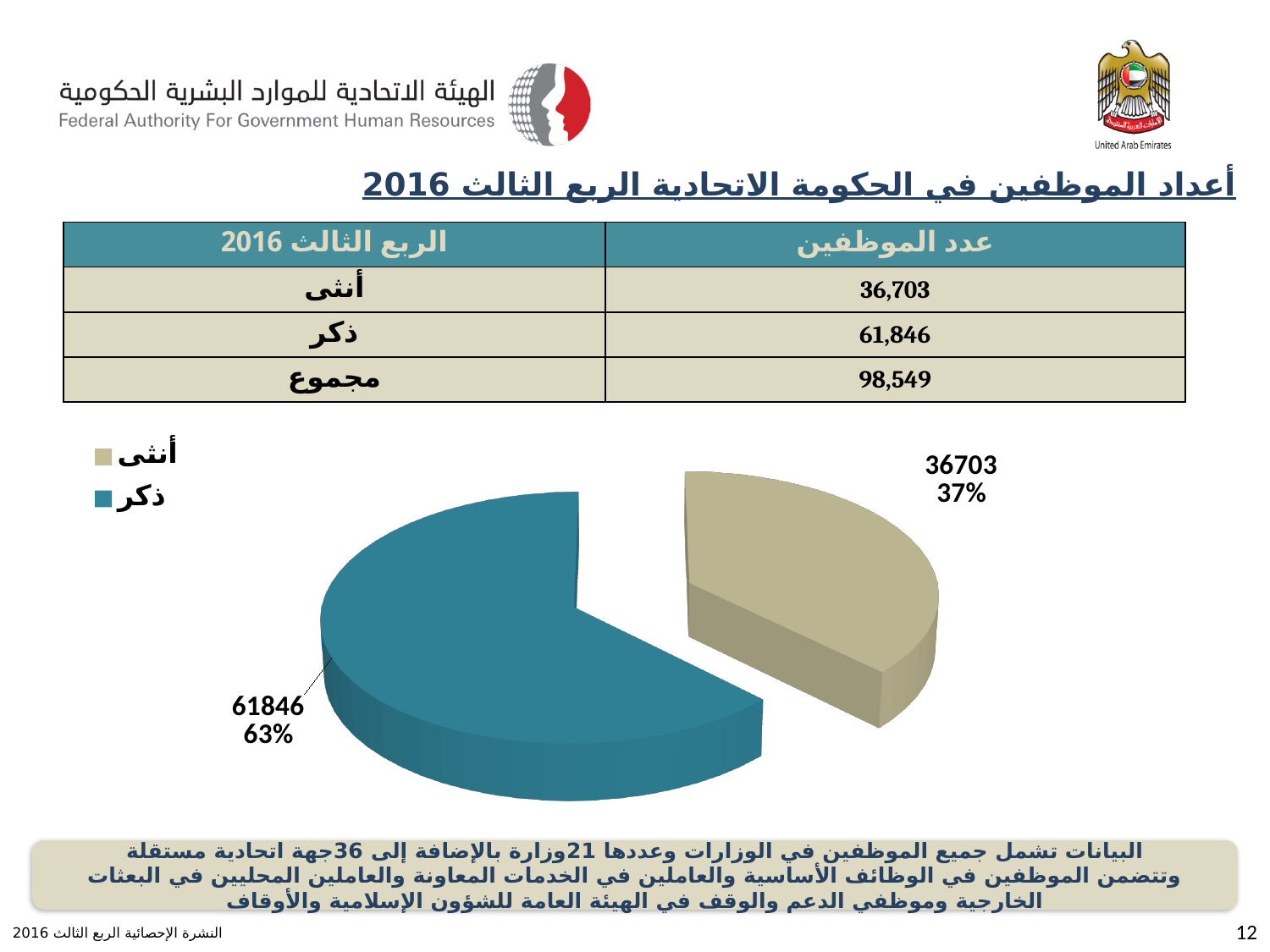
What value is labelled on the pie slice for ذكر? 61846 How many slices does the pie chart have? 2 Which slice of the pie chart is the smallest? أنثى What colour is the ذكر slice in the pie chart? teal blue What percentage share of the pie does the أنثى slice have? 37% Which is larger in the pie chart, the value for ذكر or the value for أنثى? ذكر Which slice of the pie chart is the largest? ذكر What kind of chart is shown on the slide? pie chart What is the difference between the values labelled for ذكر and أنثى in the pie chart? 25143 What value is labelled on the pie slice for أنثى? 36703 How many entries does the pie chart's legend list? 2 What percentage share of the pie does the ذكر slice have? 63%